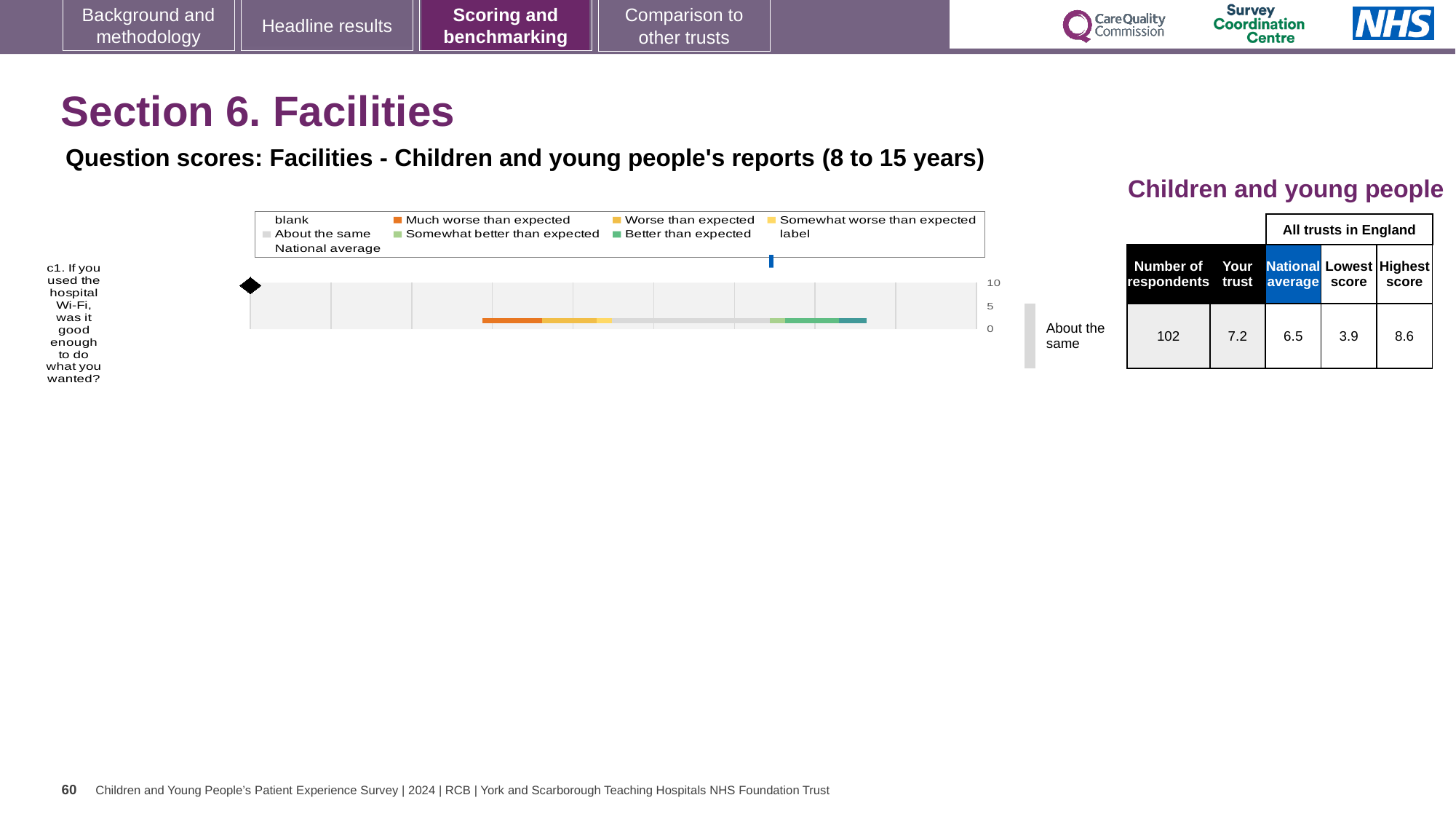
What kind of chart is shown on the slide? bar chart How many question categories are plotted on the chart? 1 How many entries does the chart legend list? 9 What is the highest tick value shown on the chart's axis? 10 Which legend entry is shown in orange? Much worse than expected Which benchmark category is shown next to the chart for question c1? About the same